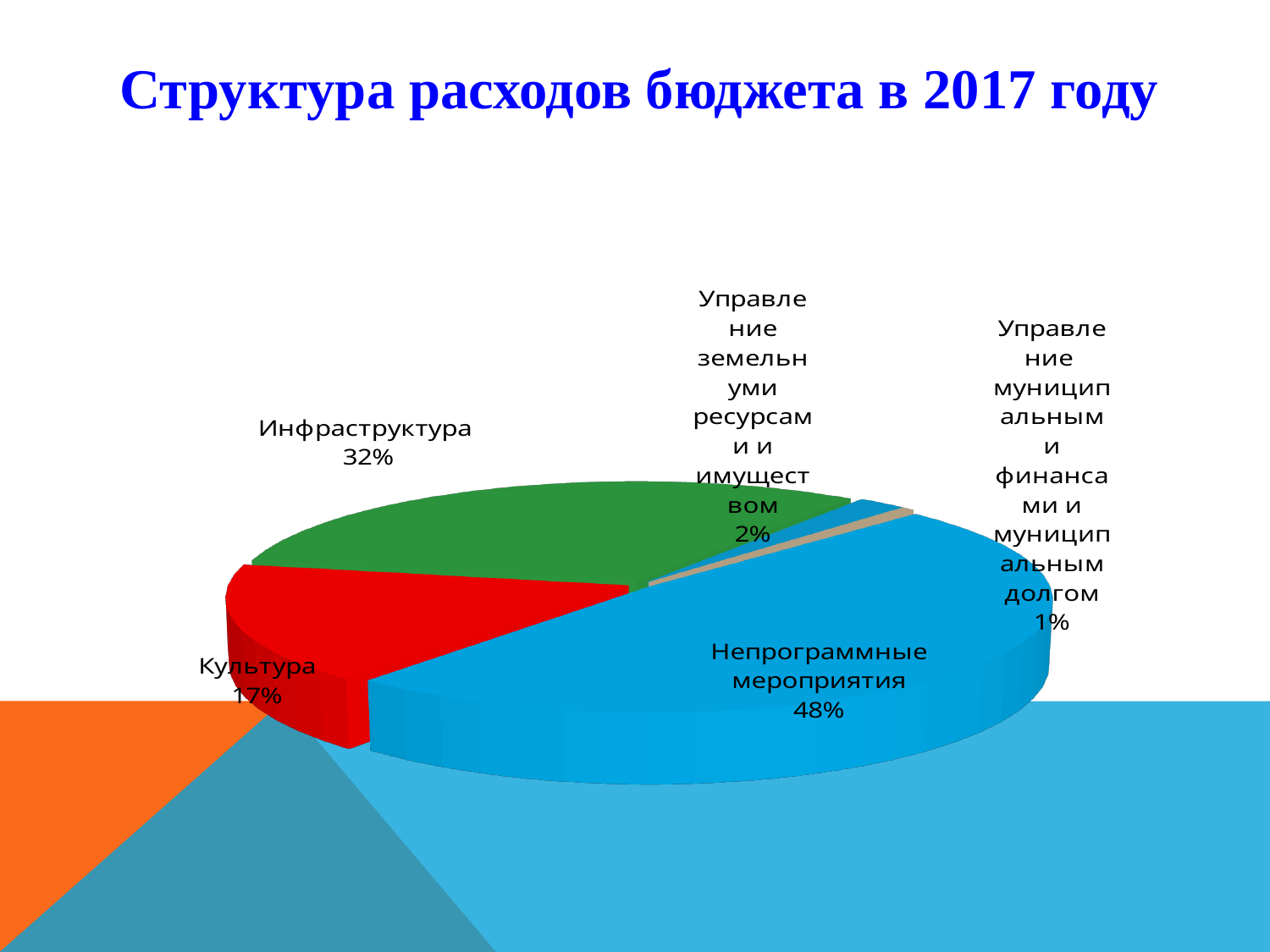
What type of chart is shown on the slide? pie chart What share of the pie does Инфраструктура take? 32% What share of the pie does Непрограммные мероприятия take? 48% Which category has the largest share of the pie? Непрограммные мероприятия Which is larger, the share for Инфраструктура or the share for Культура? Инфраструктура What is the difference in percentage points between Инфраструктура and Культура? 15 What share of the pie does Управление муниципальными финансами и муниципальным долгом take? 1% Which category has the smallest share of the pie? Управление муниципальными финансами и муниципальным долгом What is the title of the chart? Структура расходов бюджета в 2017 году How many slices does the pie chart have? 5